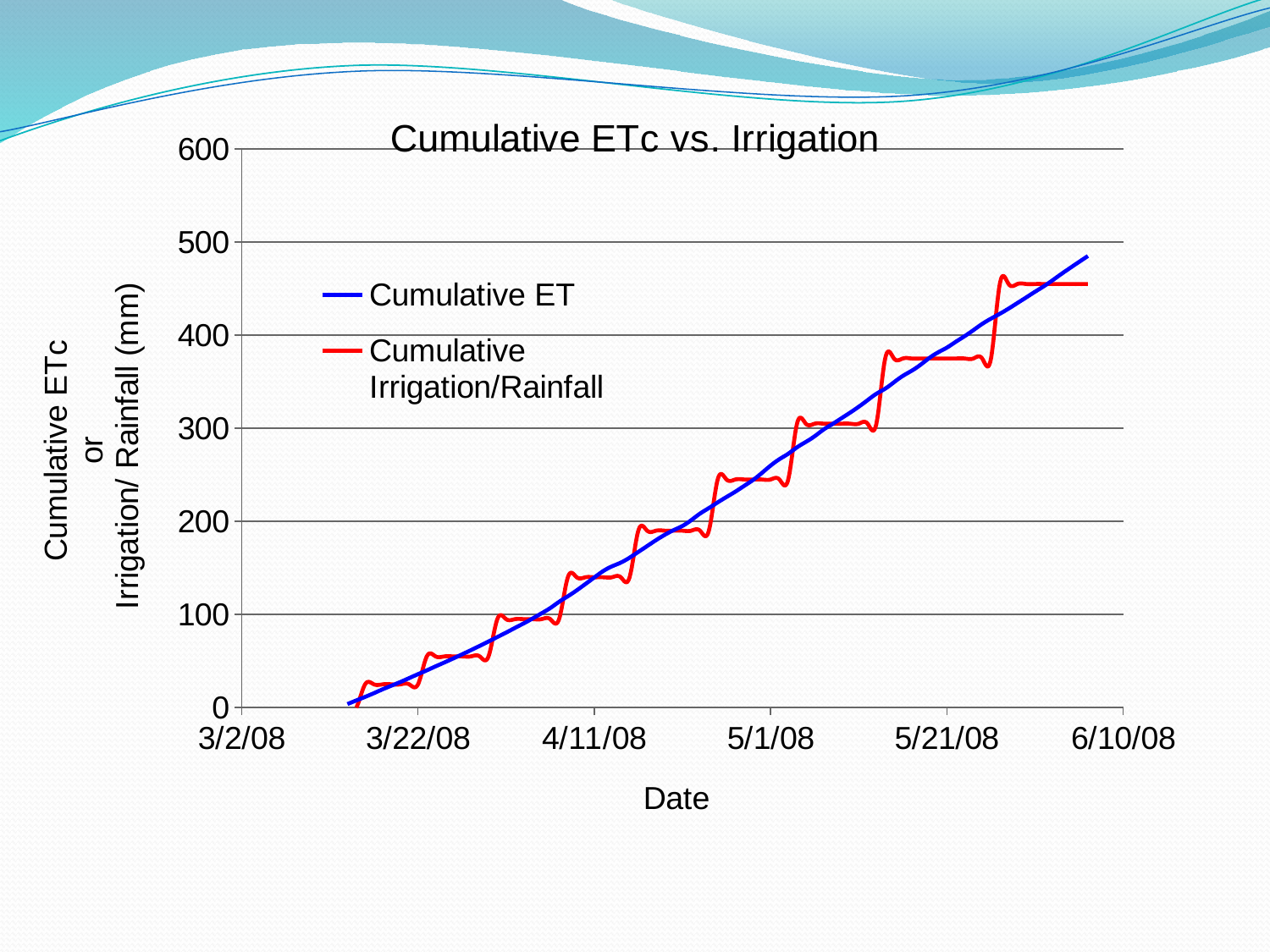
Is the value of Cumulative ET at 5/1/08 greater or less than 200? greater Does the Cumulative ET series rise or fall over time along the x axis? rise Is the value of Cumulative ET at 5/1/08 greater or less than 300? less Is the final value of Cumulative Irrigation/Rainfall (at the right end of the red line) greater or less than 500? less Which series is drawn in red? Cumulative Irrigation/Rainfall Does the Cumulative Irrigation/Rainfall series generally rise or fall from 3/22/08 to 6/10/08? rise How many series does the legend list? 2 What is the title of the chart? Cumulative ETc vs. Irrigation What kind of chart is shown on the slide? line chart